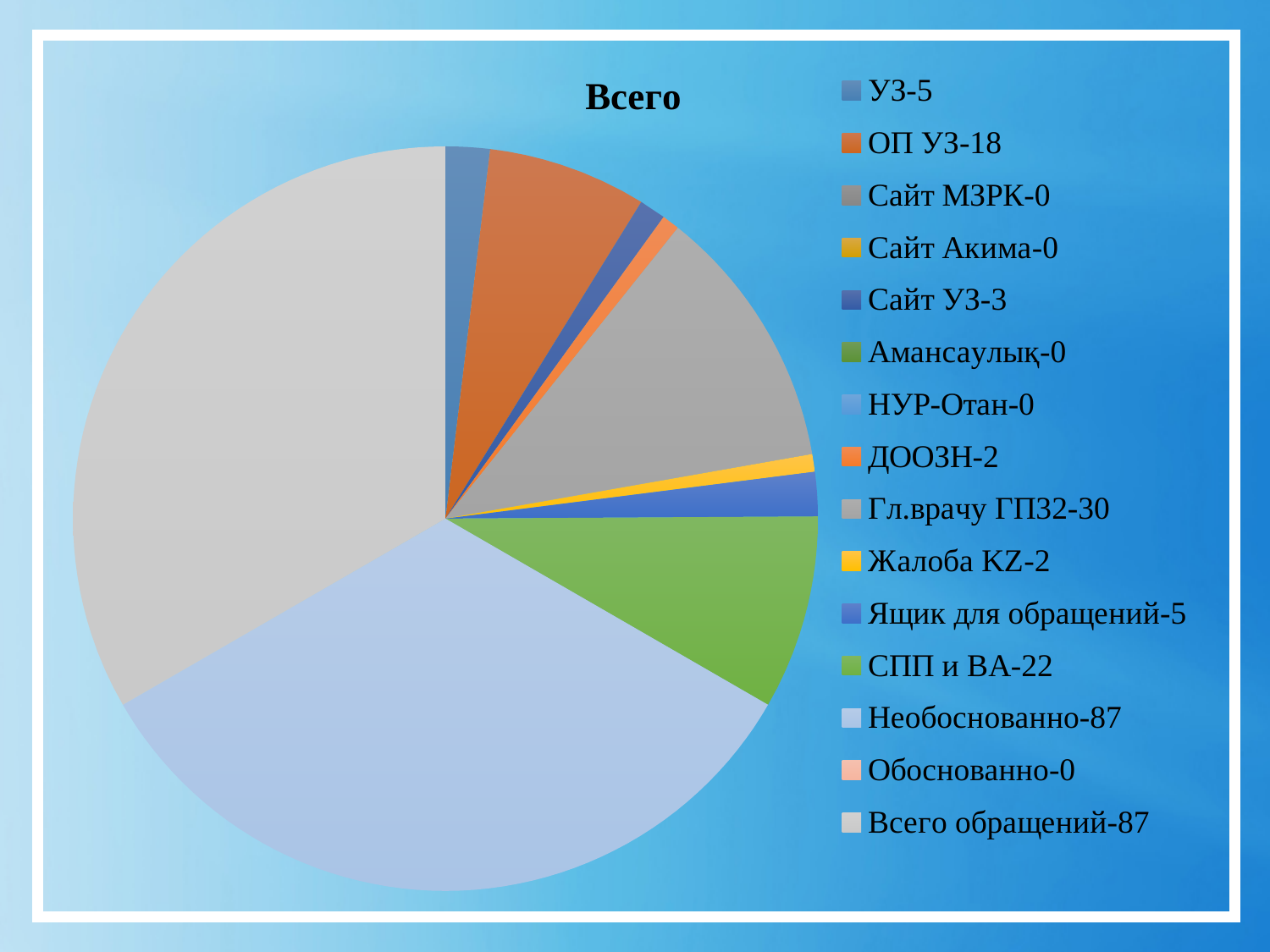
How many entries does the legend list? 15 What is the value for Сайт УЗ in the pie chart? 3 What is the value for Ящик для обращений in the pie chart? 5 What is the value for Необоснованно in the pie chart? 87 What is the value for Гл.врачу ГПЗ2 in the pie chart? 30 What is the difference between the values for Гл.врачу ГПЗ2 and ОП УЗ? 12 What kind of chart is shown on the slide? Pie chart What is the value for ОП УЗ in the pie chart? 18 What is the title of the chart? Всего What is the value for СПП и ВА in the pie chart? 22 Which is larger, Гл.врачу ГПЗ2 or УЗ? Гл.врачу ГПЗ2 Which is larger, ОП УЗ or СПП и ВА? СПП и ВА